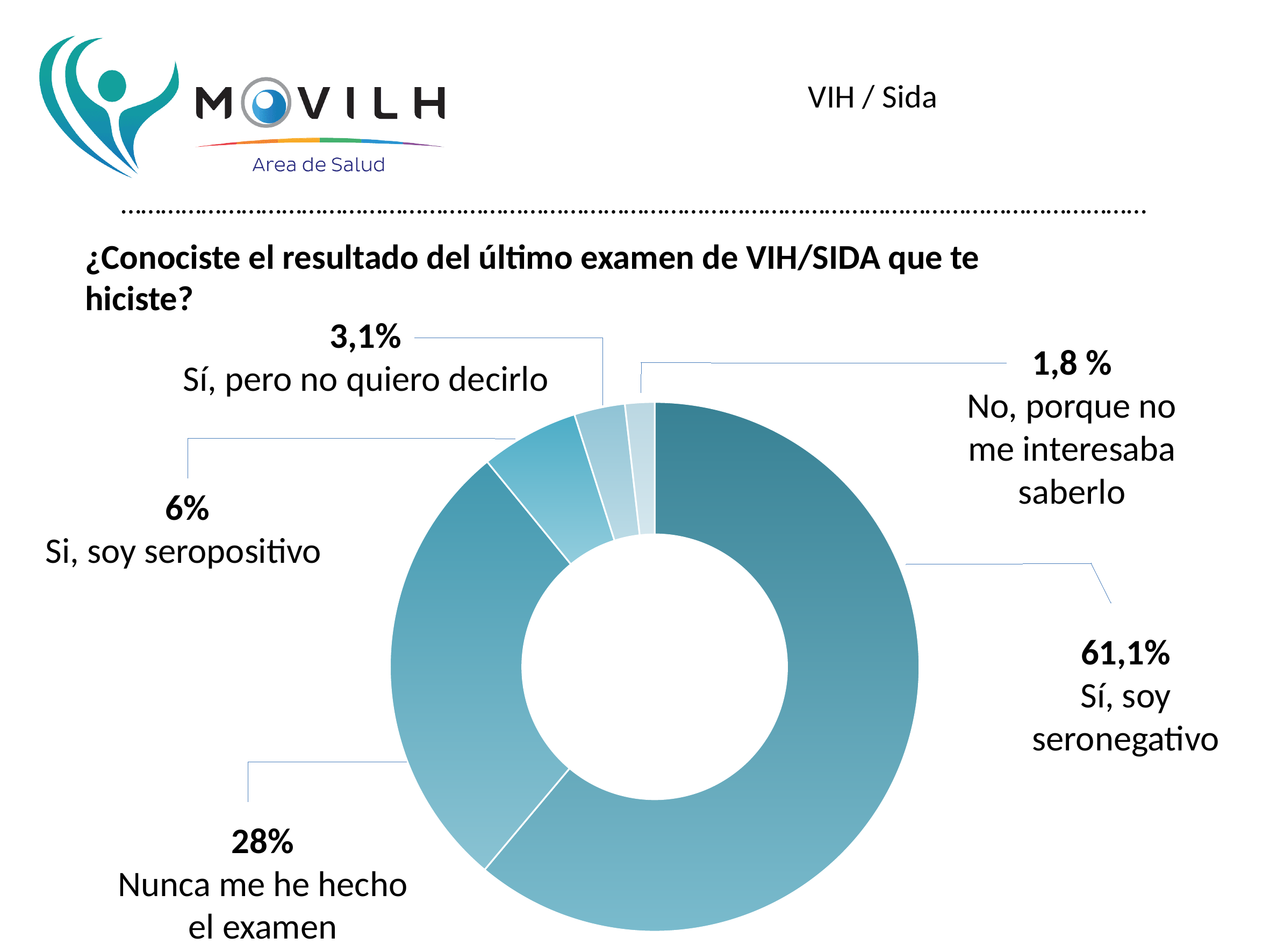
What percentage of respondents answered "Si, soy seropositivo"? 6% What percentage of respondents answered "Sí, soy seronegativo"? 61,1% What percentage of respondents answered "Sí, pero no quiero decirlo"? 3,1% What percentage of respondents answered "Nunca me he hecho el examen"? 28% What percentage of respondents answered "No, porque no me interesaba saberlo"? 1,8 % Which response has the largest share of the chart? Sí, soy seronegativo Which response has the smallest share of the chart? No, porque no me interesaba saberlo What is the difference in percentage points between "Sí, soy seronegativo" and "Nunca me he hecho el examen"? 33,1 What kind of chart is shown on the slide? Doughnut (pie) chart Which is larger: the share for "Si, soy seropositivo" or for "Sí, pero no quiero decirlo"? Si, soy seropositivo How many response categories are shown in the chart? 5 What question does the chart answer, according to the title above it? ¿Conociste el resultado del último examen de VIH/SIDA que te hiciste?